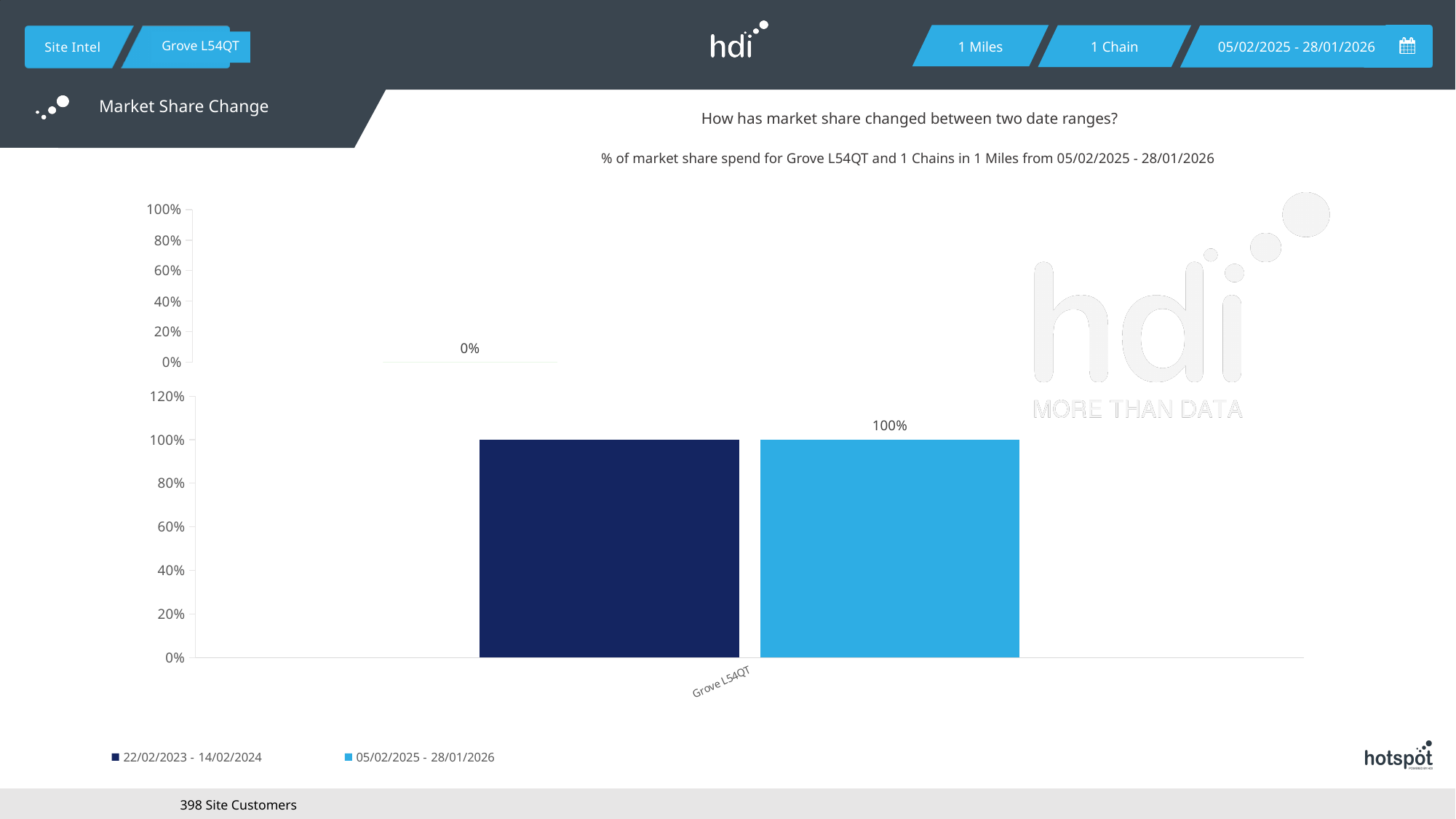
On the bottom bar chart, is the value for Grove L54QT in the 05/02/2025 - 28/01/2026 series greater or less than 80%? greater On the bottom bar chart, what is the value for Grove L54QT in the 05/02/2025 - 28/01/2026 series? 100% What is the category label on the x axis of the bottom bar chart? Grove L54QT What kind of chart is the bottom chart? bar chart On the bottom bar chart, what value does the 22/02/2023 - 14/02/2024 bar for Grove L54QT reach on the axis? 100% On the bottom bar chart, what is the difference between the 05/02/2025 - 28/01/2026 value and the 22/02/2023 - 14/02/2024 value for Grove L54QT? 0% How many categories are shown on the x axis of the bottom bar chart? 1 What value is labelled on the top chart? 0% Which legend entry on the bottom bar chart is shown in dark navy? 22/02/2023 - 14/02/2024 What is the highest tick value on the y axis of the bottom bar chart? 120% On the bottom bar chart, is the value for Grove L54QT in the 22/02/2023 - 14/02/2024 series greater or less than 60%? greater How many series does the legend of the bottom bar chart list? 2